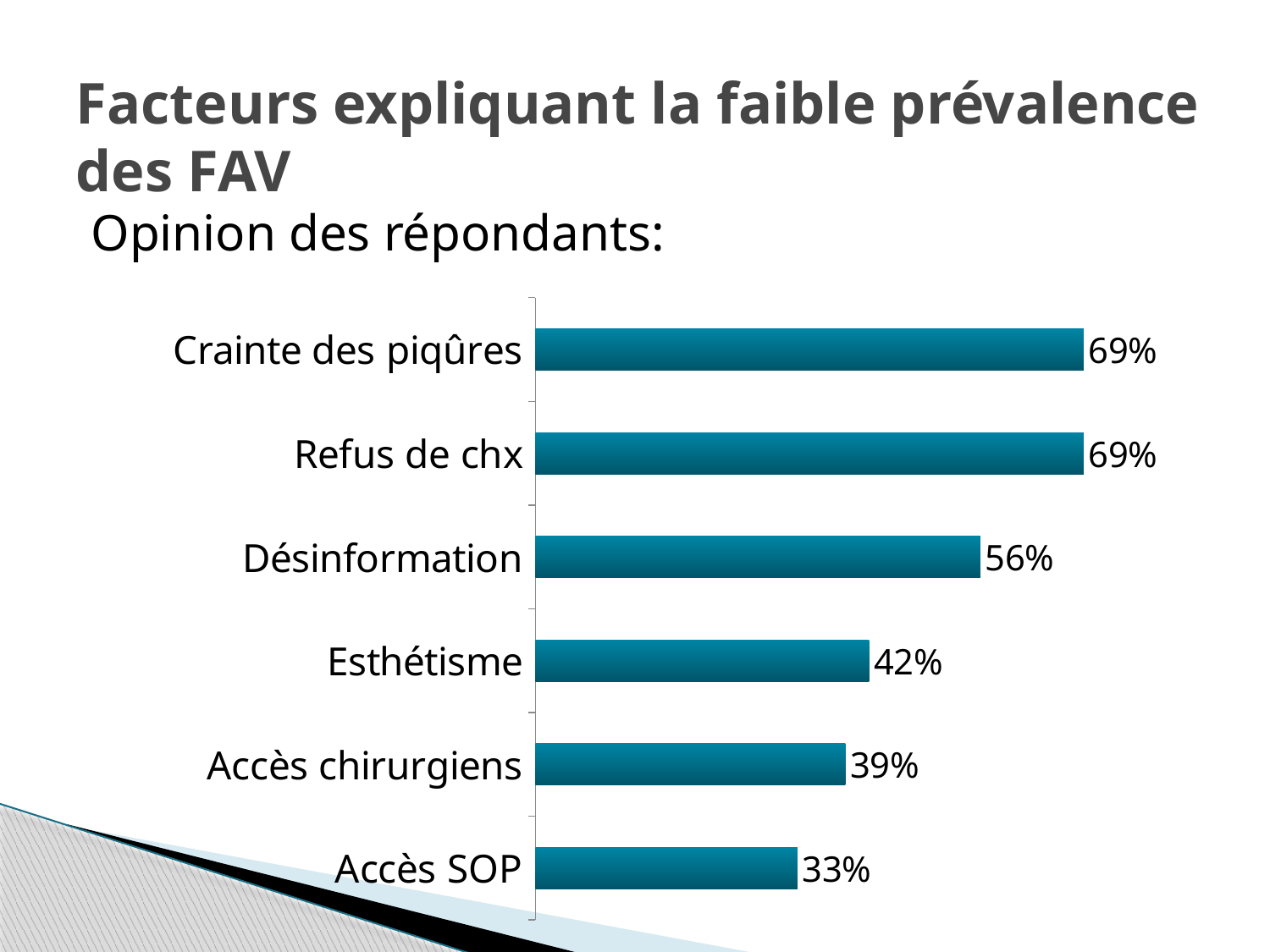
What is the value for Accès SOP? 33% What kind of chart is shown on the slide? Bar chart What is the difference between the values for Désinformation and Esthétisme? 14% What is the title of the slide containing the chart? Facteurs expliquant la faible prévalence des FAV What is the value for Accès chirurgiens? 39% What is the value for Esthétisme? 42% Which category has the lowest value? Accès SOP Which is larger, the value for Désinformation or the value for Accès chirurgiens? Désinformation What value is shown for Refus de chx? 69% How many categories are shown in the chart? 6 What is the value for Désinformation? 56% What is the difference between the values for Crainte des piqûres and Accès SOP? 36%